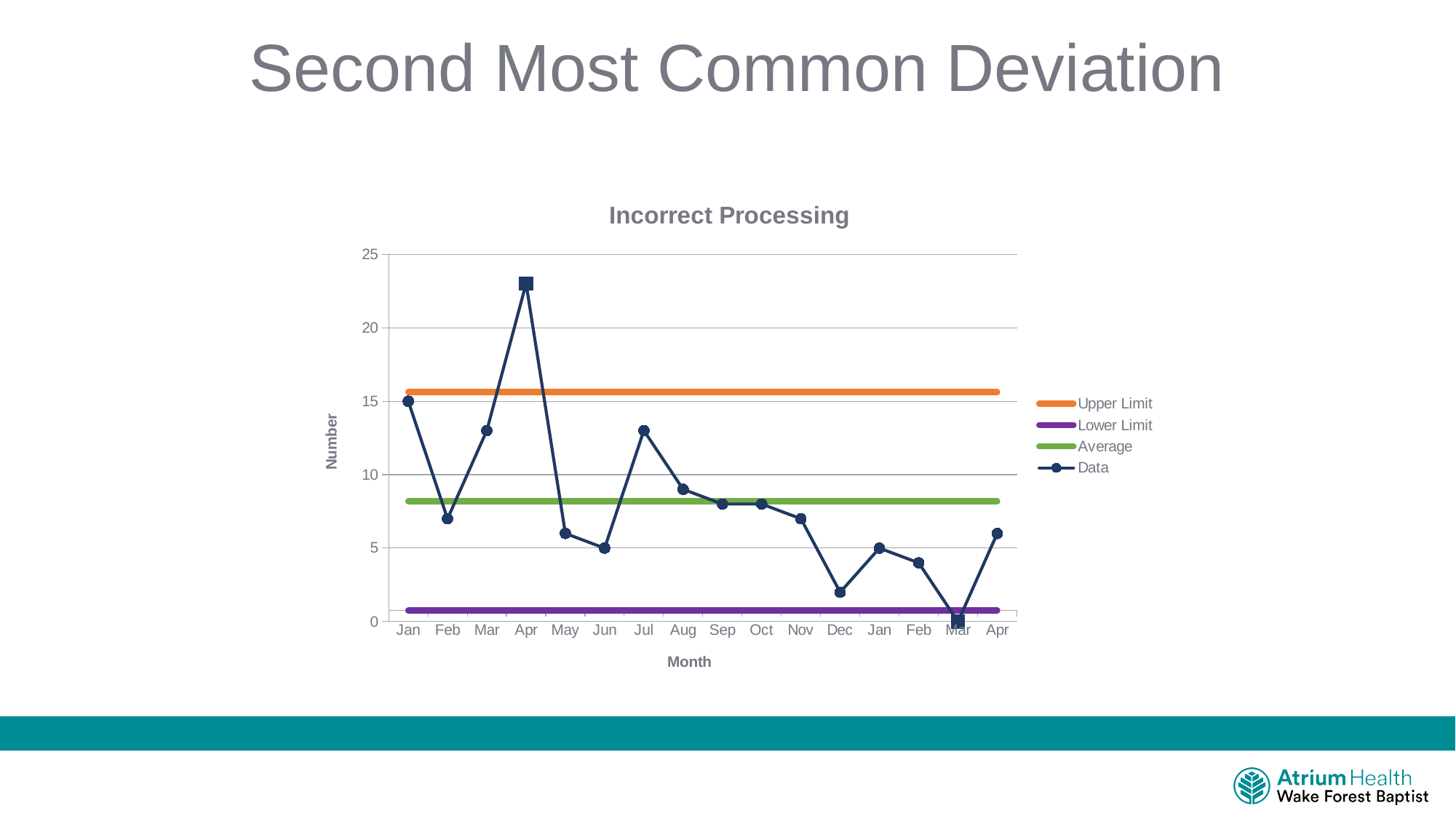
Is the Data value for Jul greater or less than 10? greater What type of chart is shown on the slide? line chart Which month has the highest value on the Data line? Apr (the first Apr) Is the Data value for Dec greater or less than 5? less Which month has the lowest value on the Data line? Mar (the second Mar) What is the label on the vertical axis? Number Which is larger on the Data line, the value for the first Mar or the value for the first Feb? Mar Does the Data line generally rise or fall from the first Jan to the last Apr? fall Is the Data value for the first Apr greater or less than 20? greater How many series does the legend list? 4 What is the title of the chart? Incorrect Processing How many data points are plotted on the Data line? 16